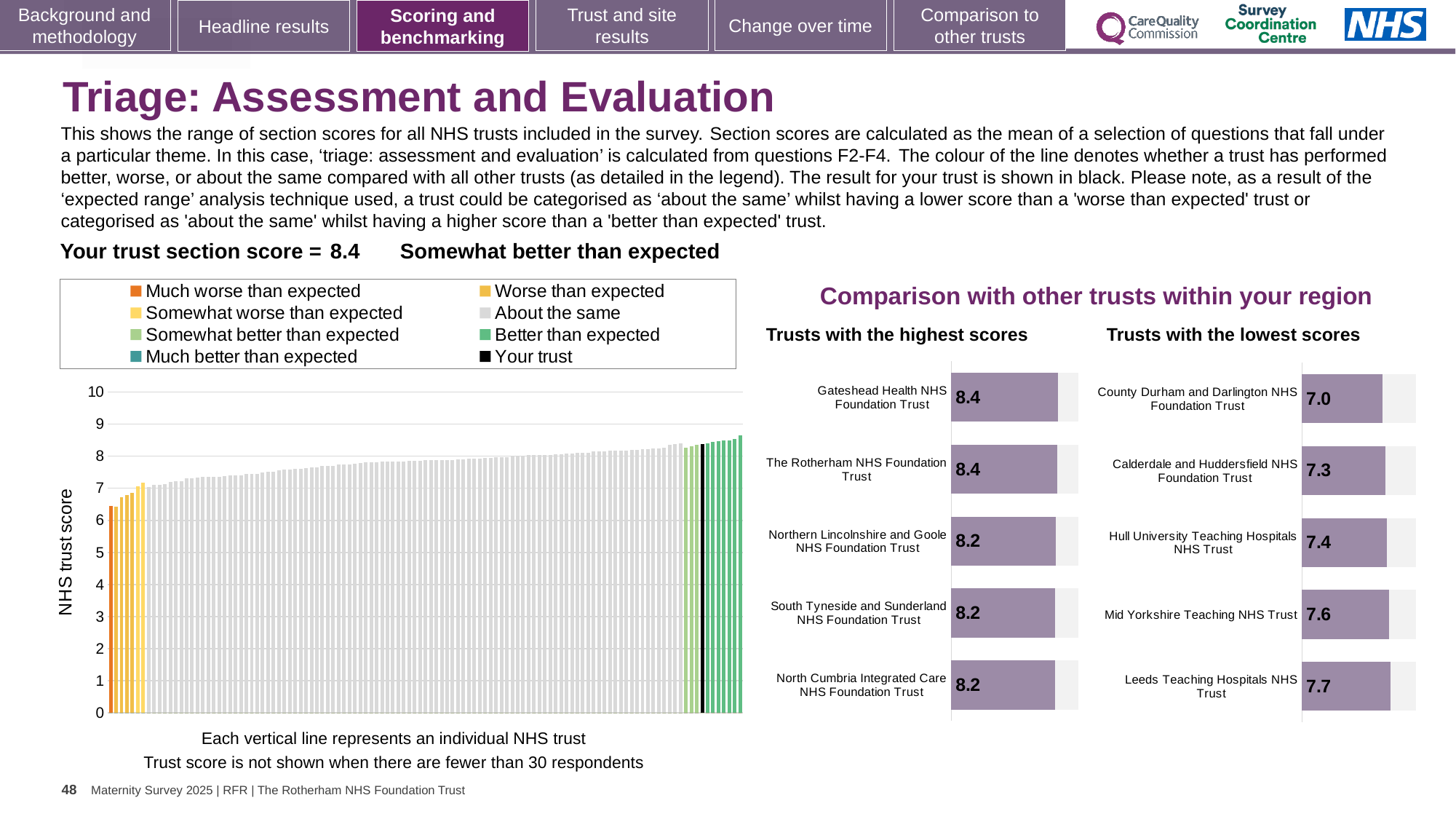
In the 'NHS trust score' chart on the left, is the value of the leftmost (lowest) bar greater or less than 7? less In the 'Trusts with the lowest scores' chart, which trust has the highest score? Leeds Teaching Hospitals NHS Trust What kind of chart is the 'NHS trust score' chart on the left of the slide? Bar chart In the 'Trusts with the lowest scores' chart, which trust has the lowest score? County Durham and Darlington NHS Foundation Trust In the 'NHS trust score' chart on the left, do the bar heights rise or fall from left to right? Rise In the 'Trusts with the lowest scores' chart, what is the score for Hull University Teaching Hospitals NHS Trust? 7.4 How many trusts are shown in the 'Trusts with the highest scores' chart? 5 How many entries does the legend above the 'NHS trust score' chart list? 8 In the 'Trusts with the highest scores' chart, what is the score for Northern Lincolnshire and Goole NHS Foundation Trust? 8.2 In the 'Trusts with the lowest scores' chart, what is the difference between the scores of Leeds Teaching Hospitals NHS Trust and County Durham and Darlington NHS Foundation Trust? 0.7 In the 'Trusts with the highest scores' chart, what is the score for Gateshead Health NHS Foundation Trust? 8.4 In the 'Trusts with the lowest scores' chart, which has the higher score: Hull University Teaching Hospitals NHS Trust or Mid Yorkshire Teaching NHS Trust? Mid Yorkshire Teaching NHS Trust